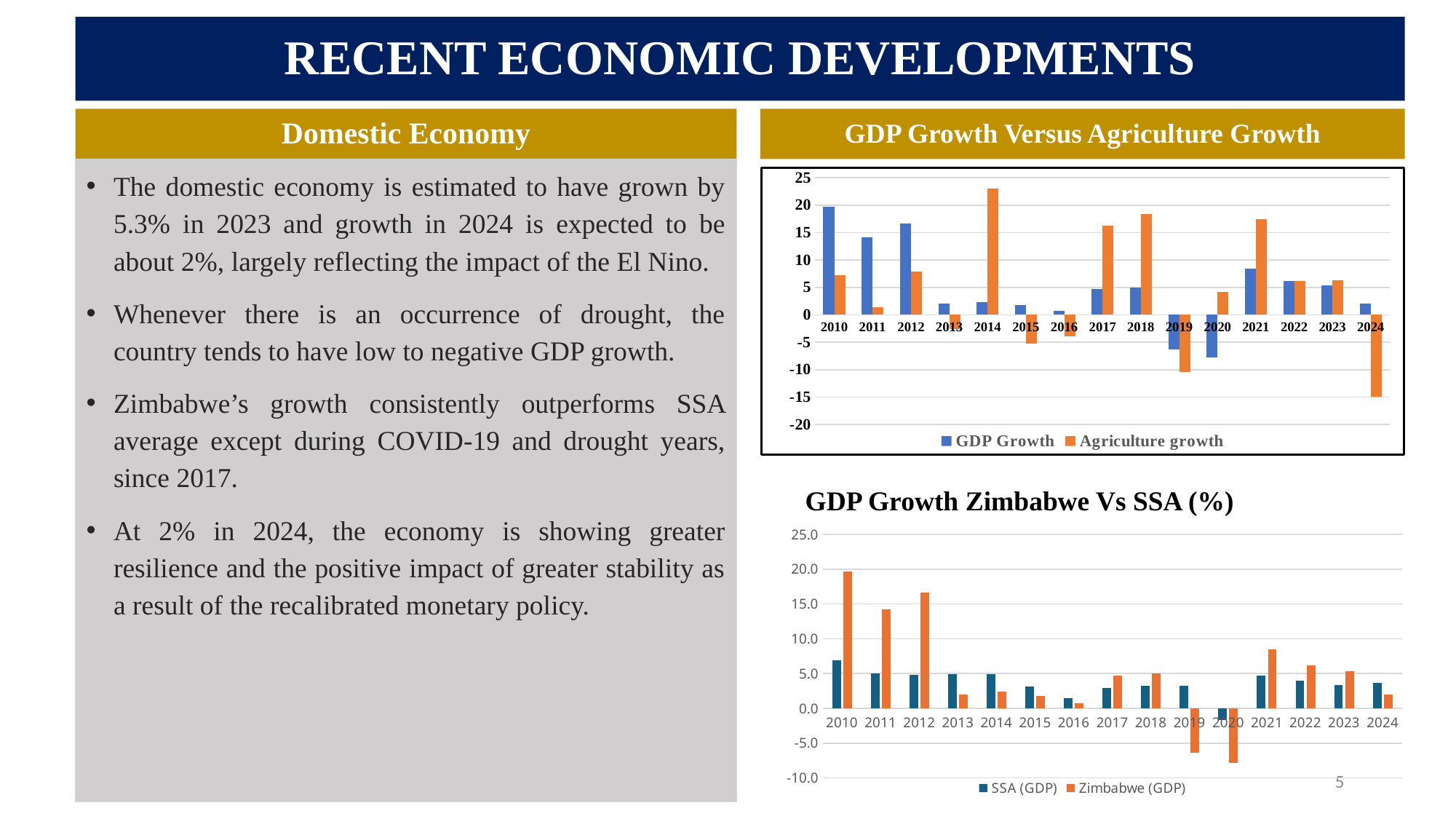
What kind of chart is 'GDP Growth Zimbabwe Vs SSA (%)'? bar chart In the 'GDP Growth Versus Agriculture Growth' chart, is the Agriculture growth value for 2024 greater or less than -10? less In the 'GDP Growth Versus Agriculture Growth' chart, which year has the highest Agriculture growth? 2014 In the 'GDP Growth Zimbabwe Vs SSA (%)' chart, is the Zimbabwe (GDP) value for 2012 greater or less than 15.0? greater In the 'GDP Growth Versus Agriculture Growth' chart, which year has the lowest Agriculture growth? 2024 In the 'GDP Growth Zimbabwe Vs SSA (%)' chart, which year has the lowest Zimbabwe (GDP) value? 2020 In the 'GDP Growth Versus Agriculture Growth' chart, how many series does the legend list? 2 In the 'GDP Growth Zimbabwe Vs SSA (%)' chart, which year has the highest Zimbabwe (GDP) value? 2010 In the 'GDP Growth Versus Agriculture Growth' chart, which year has the highest GDP Growth? 2010 In the 'GDP Growth Versus Agriculture Growth' chart, is the Agriculture growth value for 2014 greater or less than 20? greater In the 'GDP Growth Zimbabwe Vs SSA (%)' chart, which is larger in 2021, SSA (GDP) or Zimbabwe (GDP)? Zimbabwe (GDP) In the 'GDP Growth Versus Agriculture Growth' chart, how many years are shown on the x axis? 15